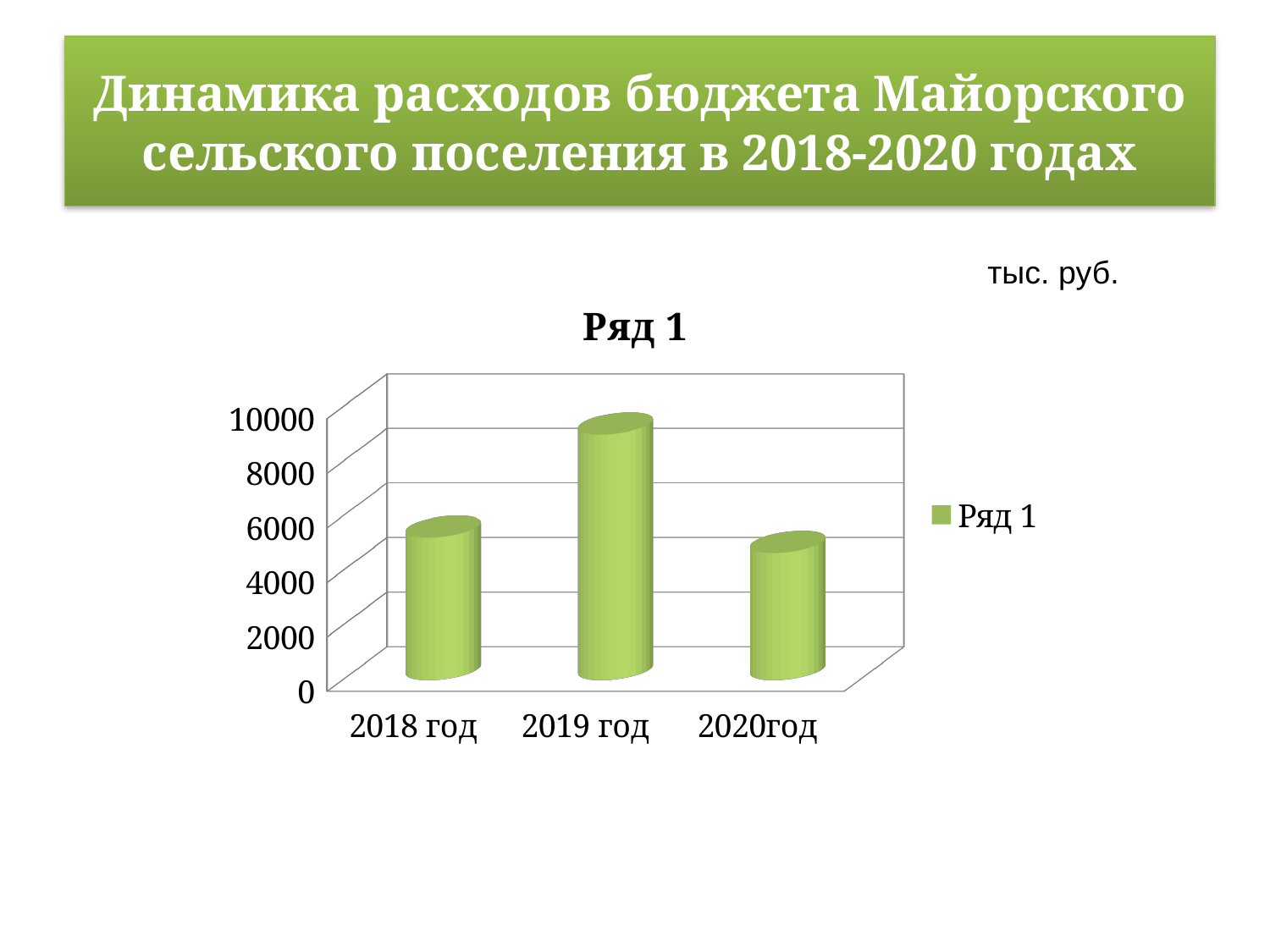
Is the value for 2020год greater or less than 6000? less What kind of chart is shown on the slide? Bar chart Is the value for 2019 год greater or less than 10000? less Is the value for 2018 год greater or less than 4000? greater Which is larger, the value for 2018 год or the value for 2020год? 2018 год How many series does the chart legend list? 1 What unit of measurement is indicated above the chart? тыс. руб. Which year has the lowest bar in the chart? 2020год How many categories (years) are shown on the x axis of the chart? 3 Do the values rise or fall from 2019 год to 2020год? fall Which year has the highest bar in the chart? 2019 год